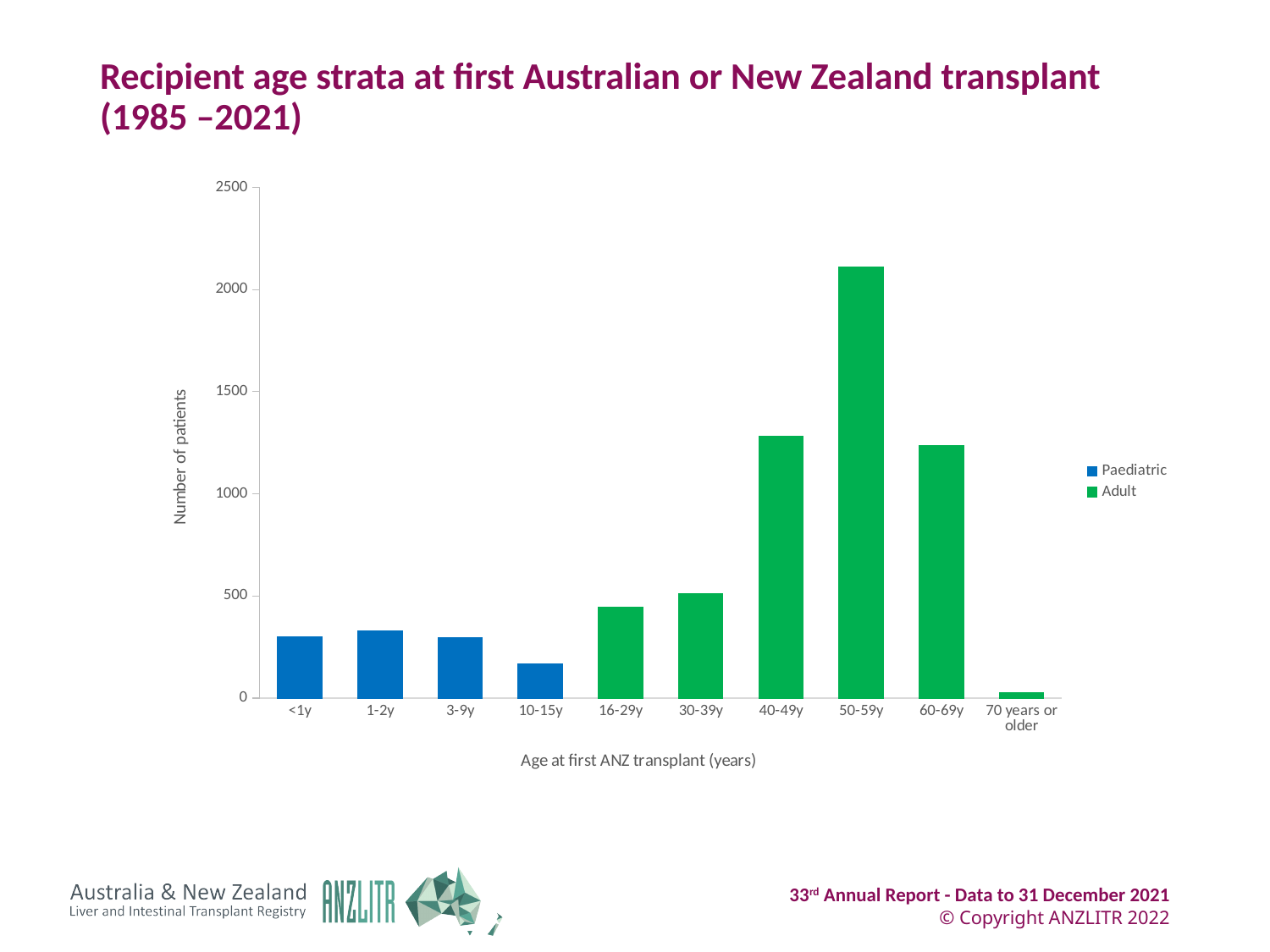
Which age group has the lowest number of patients? 70 years or older Is the value for 10-15y greater or less than 500? less Is the value for 40-49y greater or less than 1000? greater Which has more patients, 1-2y or 10-15y? 1-2y Is the value for 70 years or older greater or less than 500? less Which colour represents the Adult series in the legend? green Which age group has the highest number of patients? 50-59y Which has more patients, 40-49y or 30-39y? 40-49y How many series does the legend list? 2 How many age groups are shown on the x axis? 10 What kind of chart is shown on the slide? bar chart